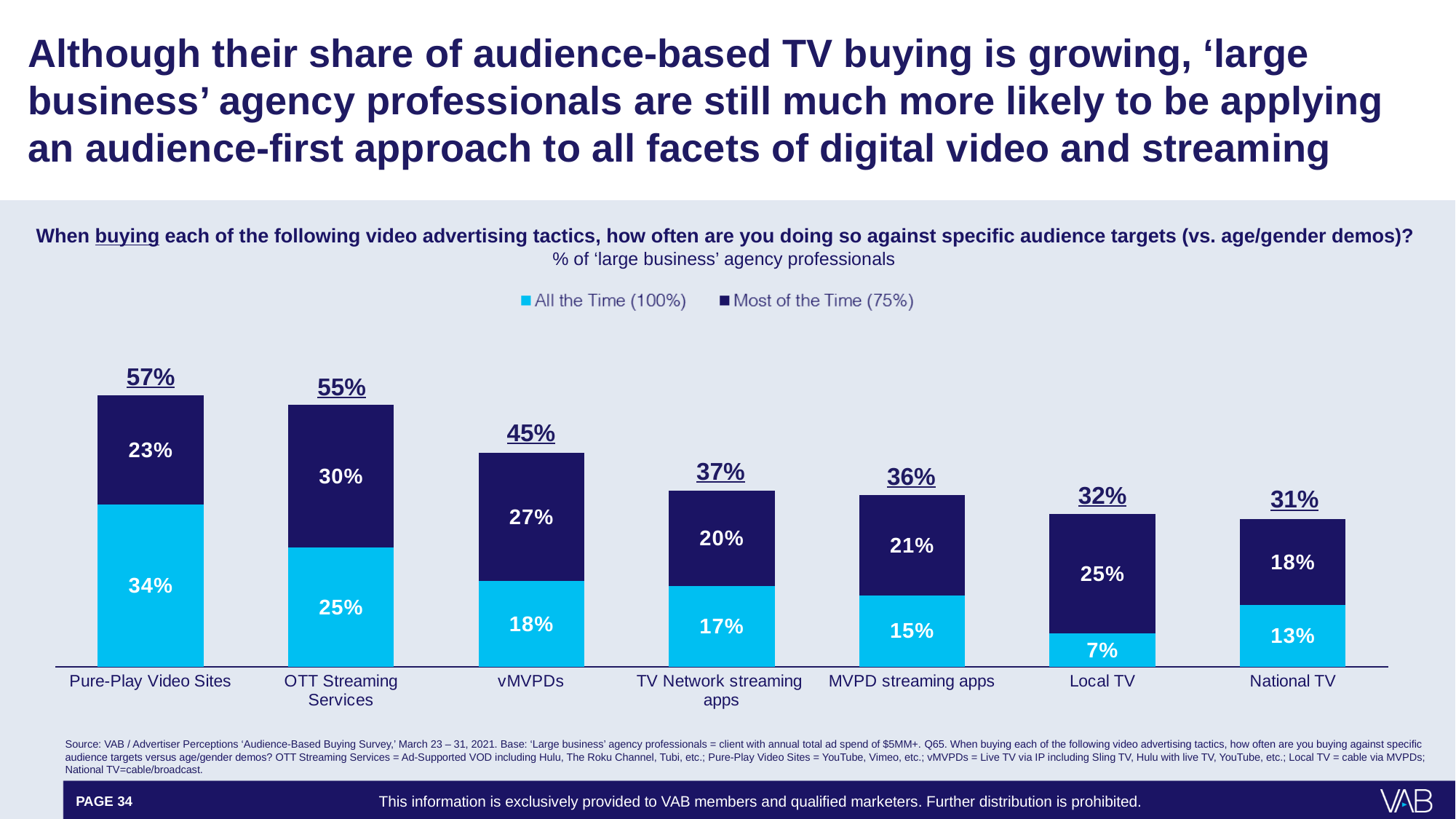
What is the 'All the Time (100%)' value for Pure-Play Video Sites? 34% Which category has the lowest total? National TV What is the 'Most of the Time (75%)' value for OTT Streaming Services? 30% How many categories are shown on the x axis? 7 Do the totals rise or fall from left to right along the x axis? Fall What is the 'All the Time (100%)' value for Local TV? 7% How many series does the legend list? 2 What is the total for vMVPDs? 45% What is the difference between the totals for Pure-Play Video Sites and National TV? 26% Which is larger: the 'All the Time (100%)' value for MVPD streaming apps or for National TV? MVPD streaming apps What kind of chart is shown? Stacked bar chart Which category has the highest total? Pure-Play Video Sites